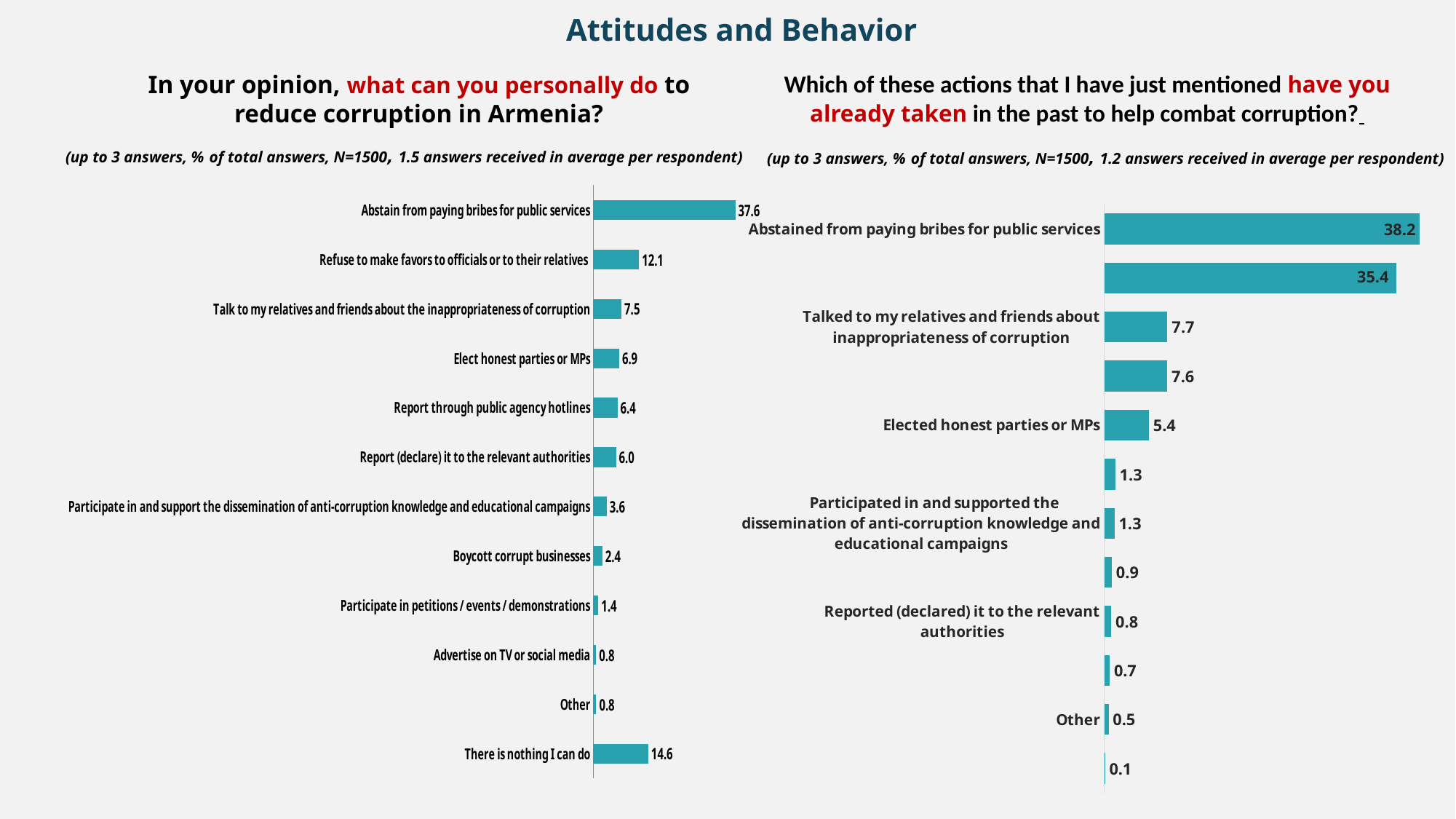
On the right chart (actions already taken to combat corruption), what is the value for "Abstained from paying bribes for public services"? 38.2 On the left chart (what can you personally do to reduce corruption), what is the value for "There is nothing I can do"? 14.6 On the right chart (actions already taken to combat corruption), what is the difference between "Talked to my relatives and friends about inappropriateness of corruption" and "Reported (declared) it to the relevant authorities"? 6.9 What type of chart is used on the left side of the slide? Bar chart On the left chart (what can you personally do to reduce corruption), what is the difference between "Refuse to make favors to officials or to their relatives" and "Talk to my relatives and friends about the inappropriateness of corruption"? 4.6 On the right chart (actions already taken to combat corruption), what is the value for "Elected honest parties or MPs"? 5.4 On the left chart (what can you personally do to reduce corruption), what is the value for "Abstain from paying bribes for public services"? 37.6 On the left chart (what can you personally do to reduce corruption), what is the value for "Boycott corrupt businesses"? 2.4 On the left chart (what can you personally do to reduce corruption), how many categories are shown? 12 On the left chart (what can you personally do to reduce corruption), which category has the highest value? Abstain from paying bribes for public services On the right chart (actions already taken to combat corruption), what is the value for "Other"? 0.5 On the left chart (what can you personally do to reduce corruption), which is larger: "Elect honest parties or MPs" or "Report through public agency hotlines"? Elect honest parties or MPs